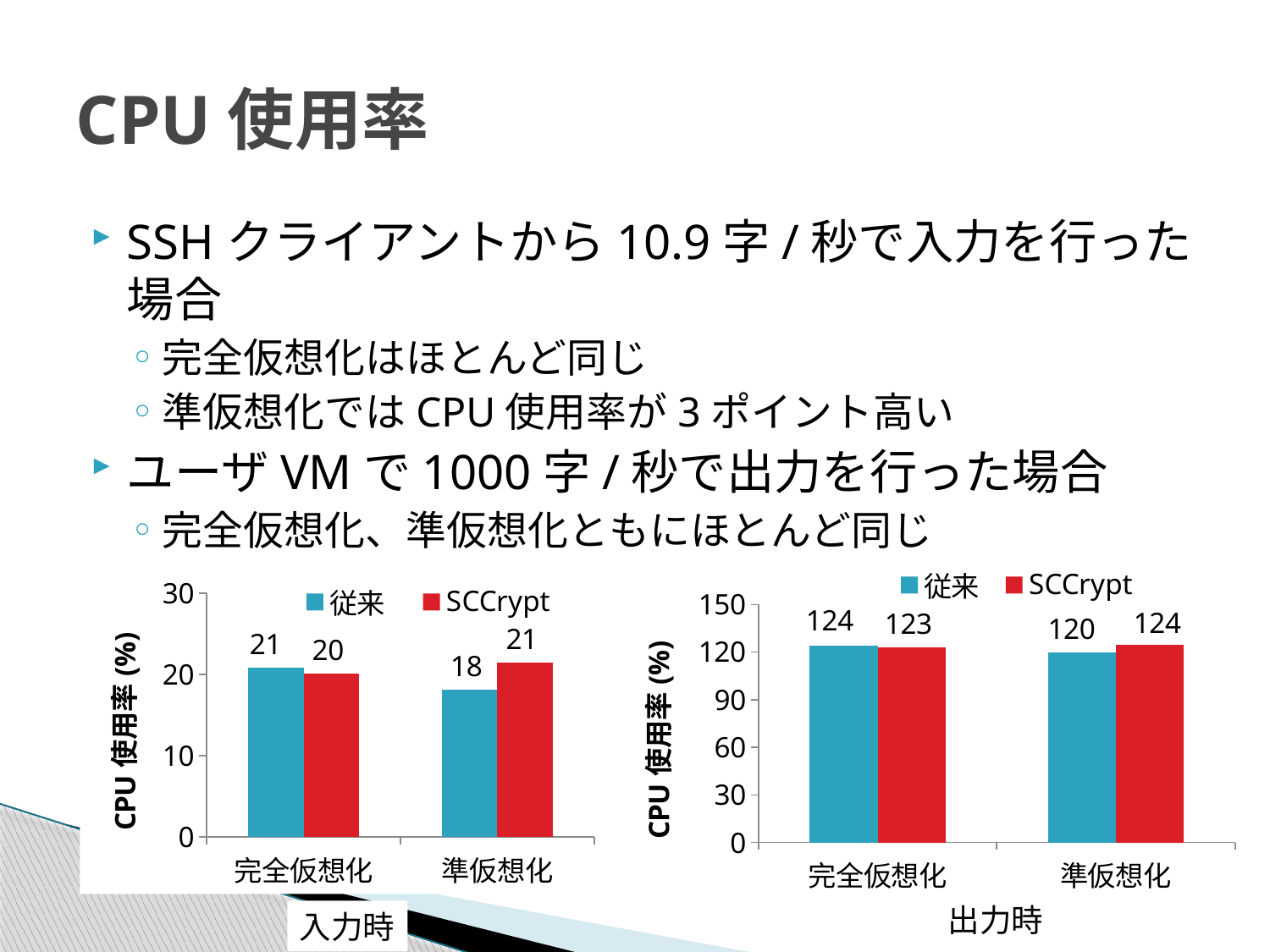
In the right chart (出力時), what is the difference between SCCrypt and 従来 under 準仮想化? 4 In the right chart (出力時), what is the CPU usage for 従来 under 完全仮想化? 124 In the left chart (入力時), what is the CPU usage for SCCrypt under 準仮想化? 21 In the left chart (入力時), what is the CPU usage for 従来 under 完全仮想化? 21 How many series does the legend of the left chart (入力時) list? 2 In the left chart (入力時), what is the CPU usage for 従来 under 準仮想化? 18 In the left chart (入力時), which series has the lowest value overall? 従来 (準仮想化) In the right chart (出力時), is the value for 従来 under 準仮想化 greater or less than 90? greater In the right chart (出力時), what is the CPU usage for 従来 under 準仮想化? 120 What kind of chart is the right chart (出力時)? bar chart In the right chart (出力時), what is the CPU usage for SCCrypt under 完全仮想化? 123 In the left chart (入力時), what is the difference between SCCrypt and 従来 under 準仮想化? 3